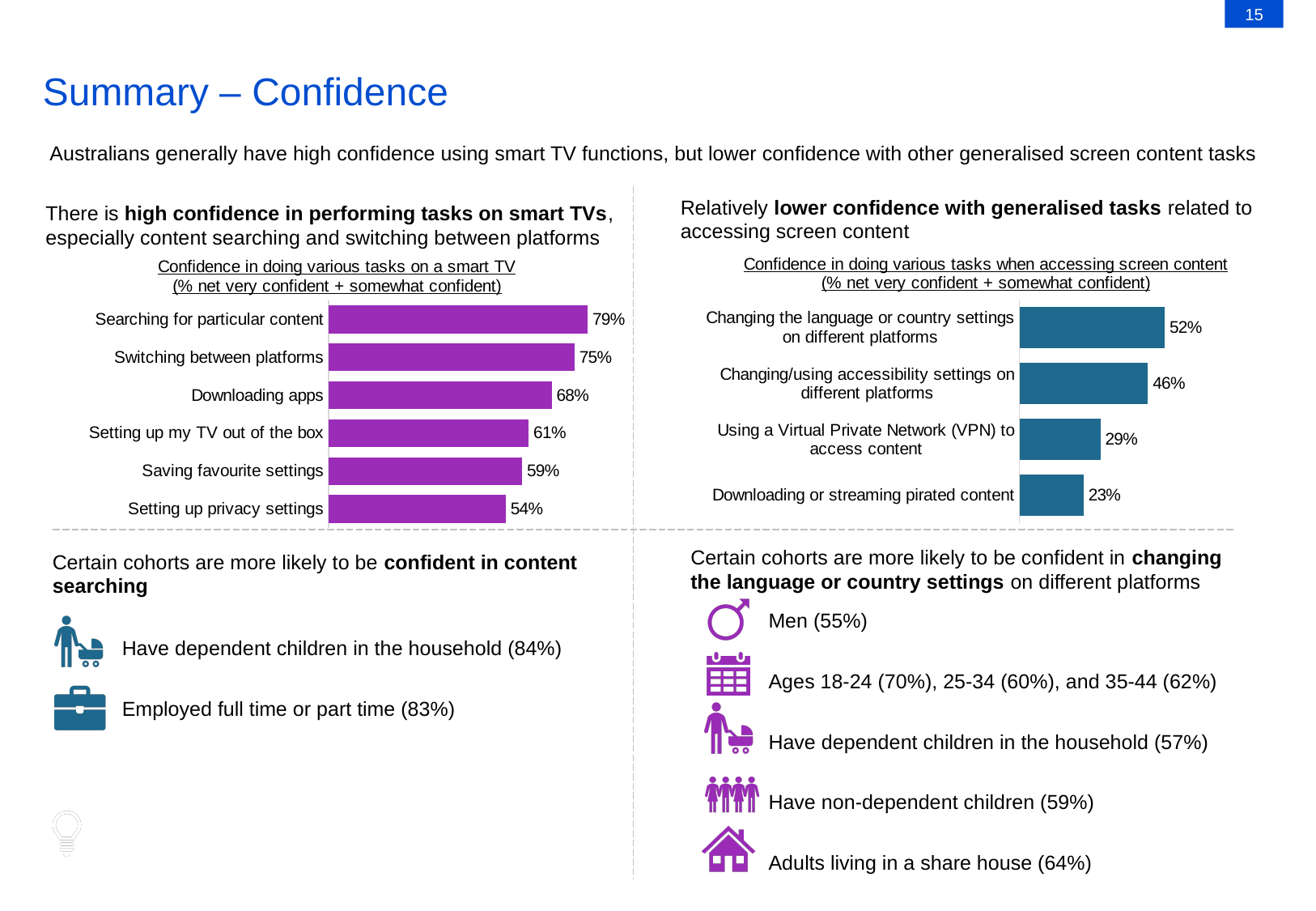
In the 'Confidence in doing various tasks when accessing screen content' chart, how many tasks are shown? 4 In the 'Confidence in doing various tasks on a smart TV' chart, how many tasks are shown? 6 In the 'Confidence in doing various tasks on a smart TV' chart, what is the difference between Switching between platforms and Downloading apps? 7% In the 'Confidence in doing various tasks when accessing screen content' chart, what is the value for Using a Virtual Private Network (VPN) to access content? 29% In the 'Confidence in doing various tasks when accessing screen content' chart, what is the difference between Changing the language or country settings and Changing/using accessibility settings? 6% In the 'Confidence in doing various tasks when accessing screen content' chart, which task has the highest value? Changing the language or country settings on different platforms In the 'Confidence in doing various tasks on a smart TV' chart, what is the value for Searching for particular content? 79% What type of chart is the 'Confidence in doing various tasks on a smart TV' chart? Bar chart In the 'Confidence in doing various tasks when accessing screen content' chart, which task has the lowest value? Downloading or streaming pirated content In the 'Confidence in doing various tasks on a smart TV' chart, which task has the lowest value? Setting up privacy settings Which is larger: Saving favourite settings in the smart TV chart or Changing the language or country settings in the screen content chart? Saving favourite settings In the 'Confidence in doing various tasks on a smart TV' chart, what is the value for Setting up my TV out of the box? 61%